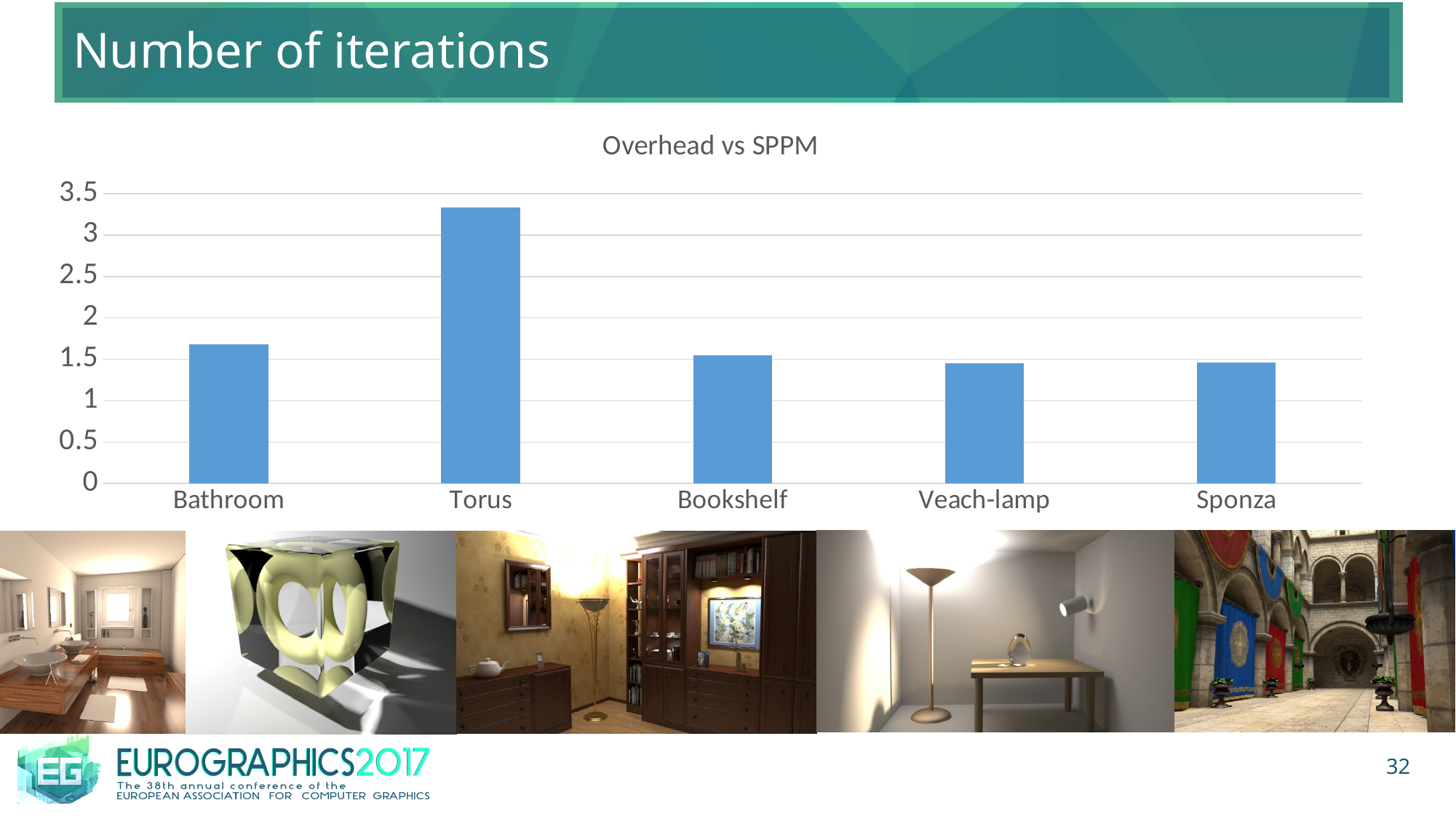
Is the value for Bookshelf greater or less than 2? less What kind of chart is shown on the slide? bar chart Is the value for Torus greater or less than 3? greater Is the value for Bathroom greater or less than 1.5? greater How many scenes (categories) are plotted in the chart? 5 Which is larger, the value for Bathroom or the value for Veach-lamp? Bathroom What is the highest value shown on the vertical axis? 3.5 Which is larger, the value for Torus or the value for Bathroom? Torus What is the title of the chart? Overhead vs SPPM Which scene has the highest overhead vs SPPM? Torus